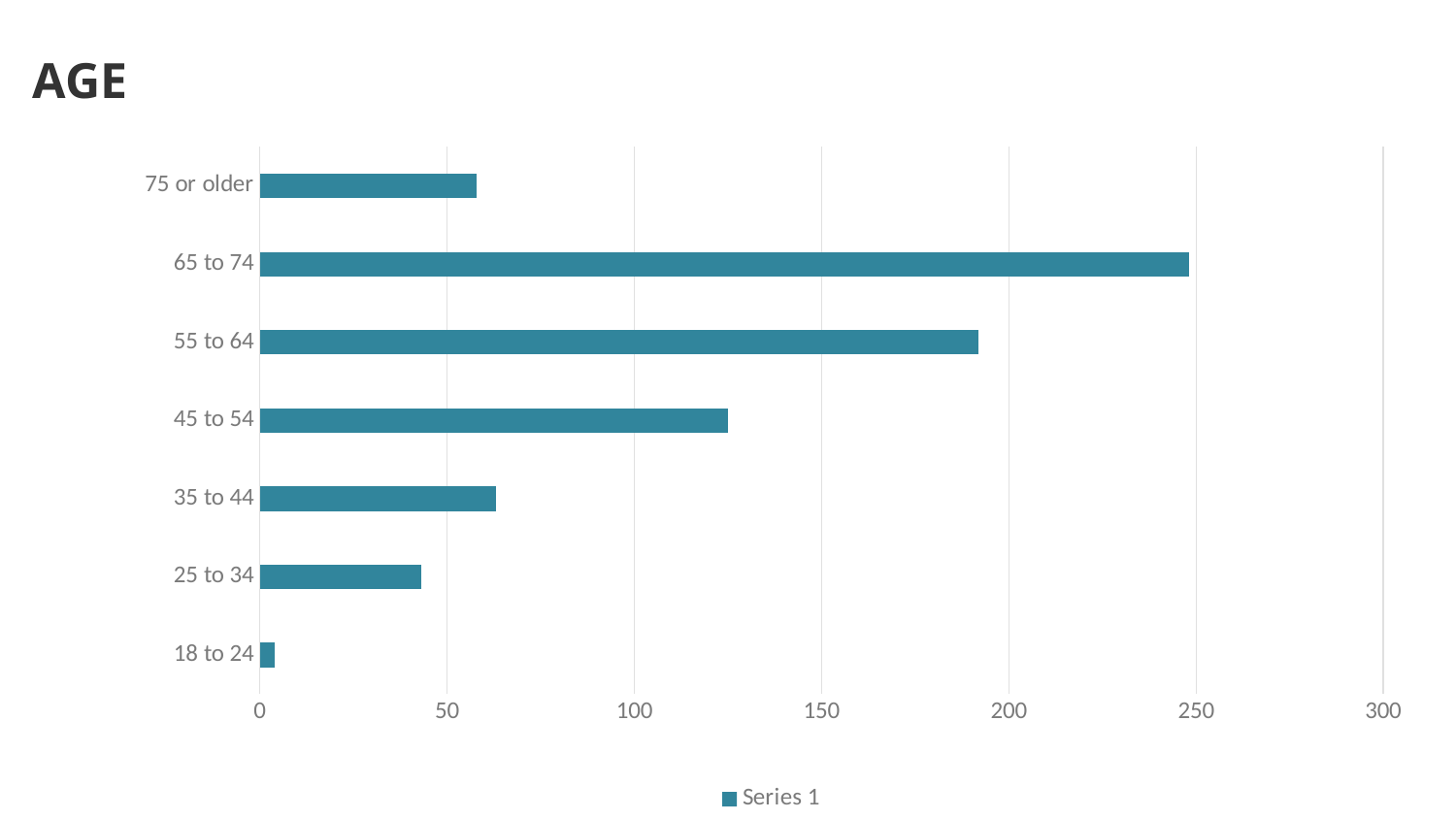
Is the value for 45 to 54 greater or less than 100? greater Which is larger, the value for 55 to 64 or the value for 45 to 54? 55 to 64 Which age group has the highest value? 65 to 74 How many age groups are shown on the chart? 7 Which is larger, the value for 25 to 34 or the value for 35 to 44? 35 to 44 Which age group has the lowest value? 18 to 24 Is the value for 75 or older greater or less than 100? less Is the value for 25 to 34 greater or less than 50? less How many series does the legend list? 1 What is the title of the slide? AGE What kind of chart is shown on the slide? Bar chart